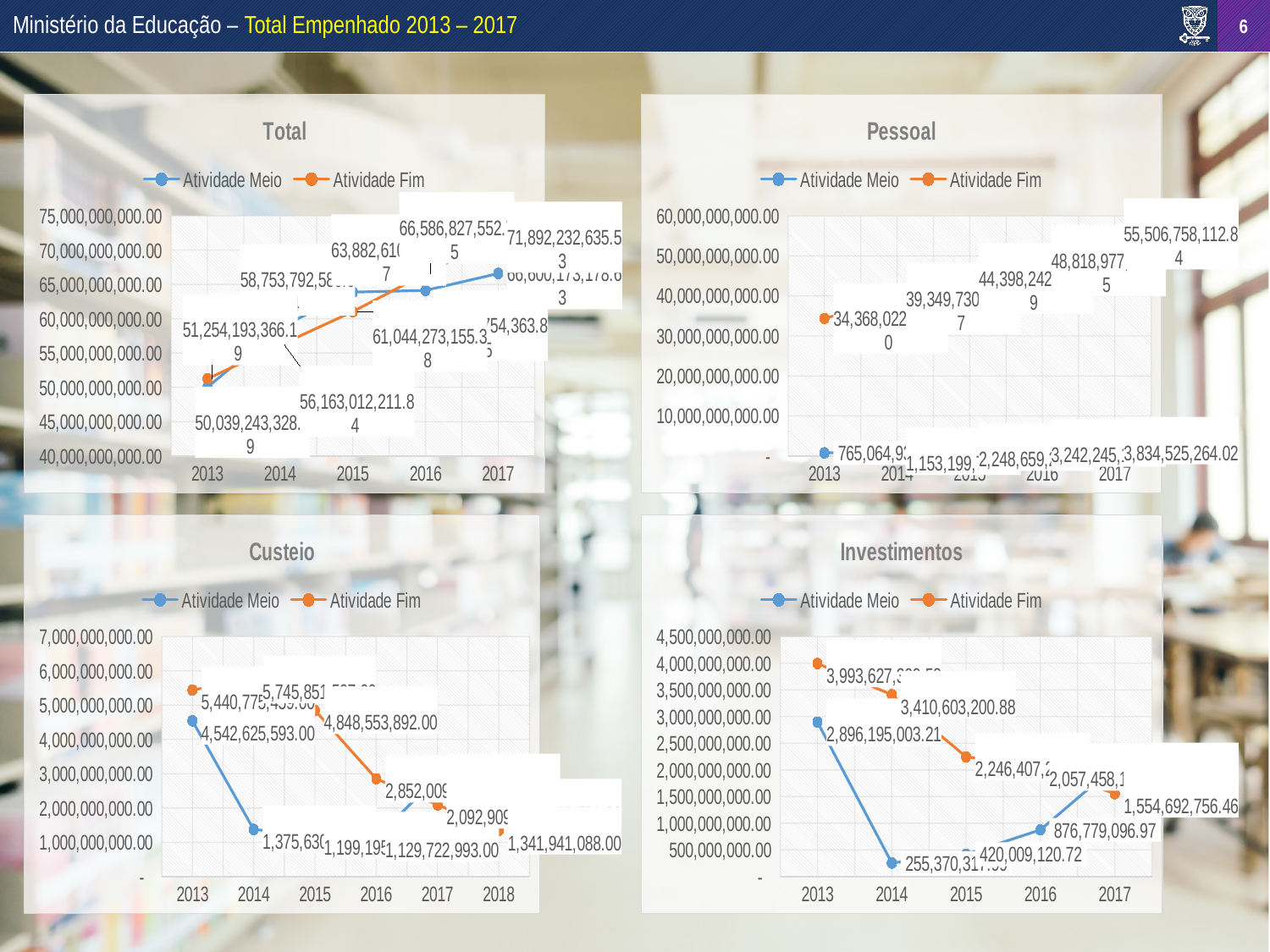
In the 'Pessoal' chart, does the Atividade Meio series rise or fall from 2013 to 2017? rise In the 'Pessoal' chart, what is the value for Atividade Meio in 2017? 3,834,525,264.02 How many series does the legend of the 'Pessoal' chart list? 2 In the 'Total' chart, is the value for Atividade Meio in 2013 greater or less than 55,000,000,000.00? less In the 'Pessoal' chart, which series has the larger value in 2017, Atividade Meio or Atividade Fim? Atividade Fim How many years are shown on the x axis of the 'Custeio' chart? 6 What kind of chart is the 'Total' chart? line chart In the 'Pessoal' chart, what is the value for Atividade Fim in 2017? 55,506,758,112.84 In the 'Investimentos' chart, what is the value for Atividade Fim in 2017? 1,554,692,756.46 In the 'Investimentos' chart, does the Atividade Fim series rise or fall from 2013 to 2017? fall What are the two legend entries on the 'Investimentos' chart? Atividade Meio and Atividade Fim In the 'Investimentos' chart, what is the value for Atividade Meio in 2013? 2,896,195,003.21